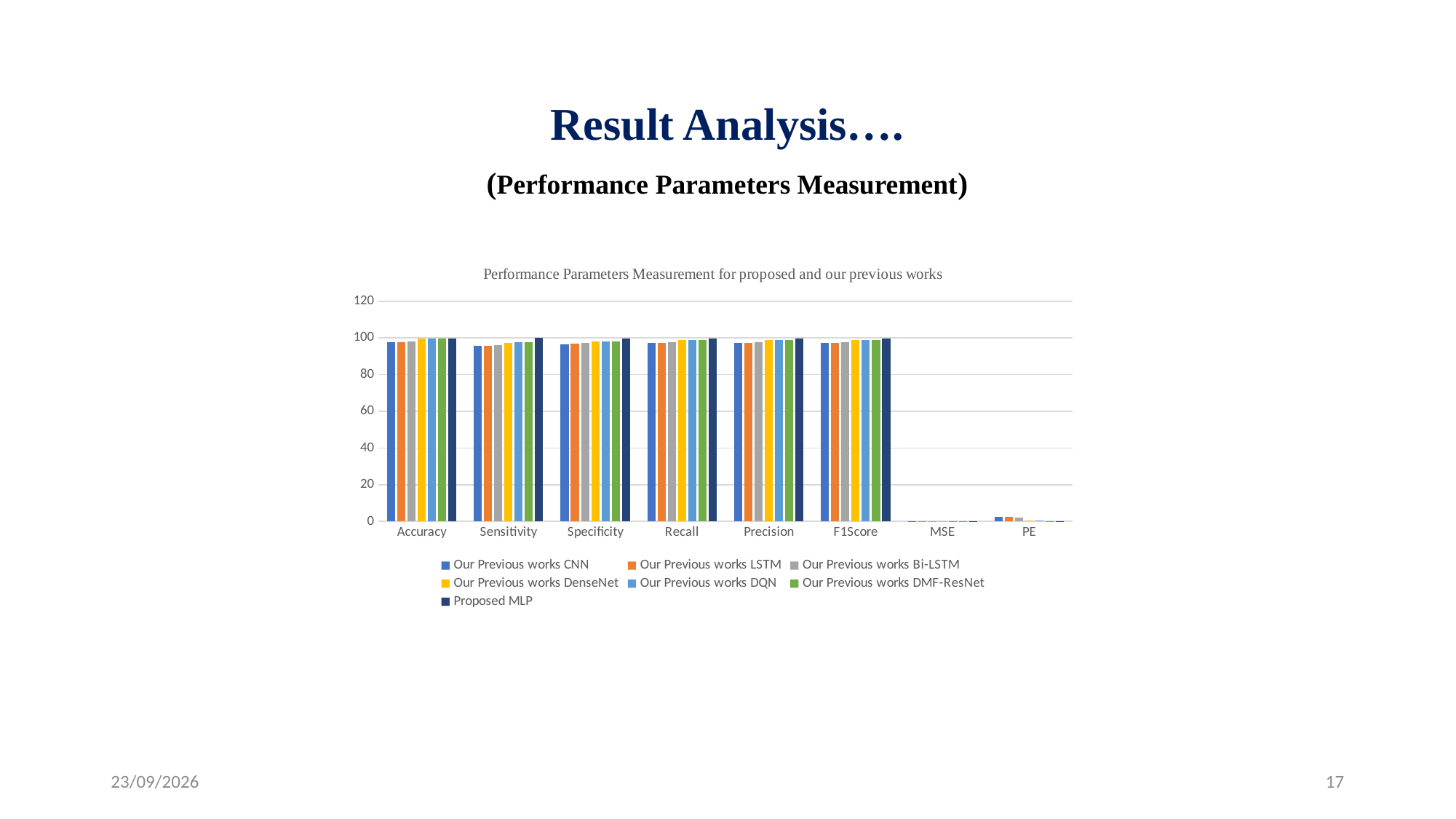
Is the F1Score value for Our Previous works DenseNet greater or less than 40? greater Is the PE value for Our Previous works Bi-LSTM greater or less than 20? less Is the MSE value for Our Previous works CNN greater or less than 20? less Which is larger for Our Previous works CNN: the Recall value or the PE value? Recall How many series does the chart's legend list? 7 Which is larger for Proposed MLP: the Accuracy value or the MSE value? Accuracy What kind of chart is shown on the slide? bar chart What is the title of the chart? Performance Parameters Measurement for proposed and our previous works How many categories are shown along the x axis of the chart? 8 Which series is shown in the darkest navy colour in the legend? Proposed MLP